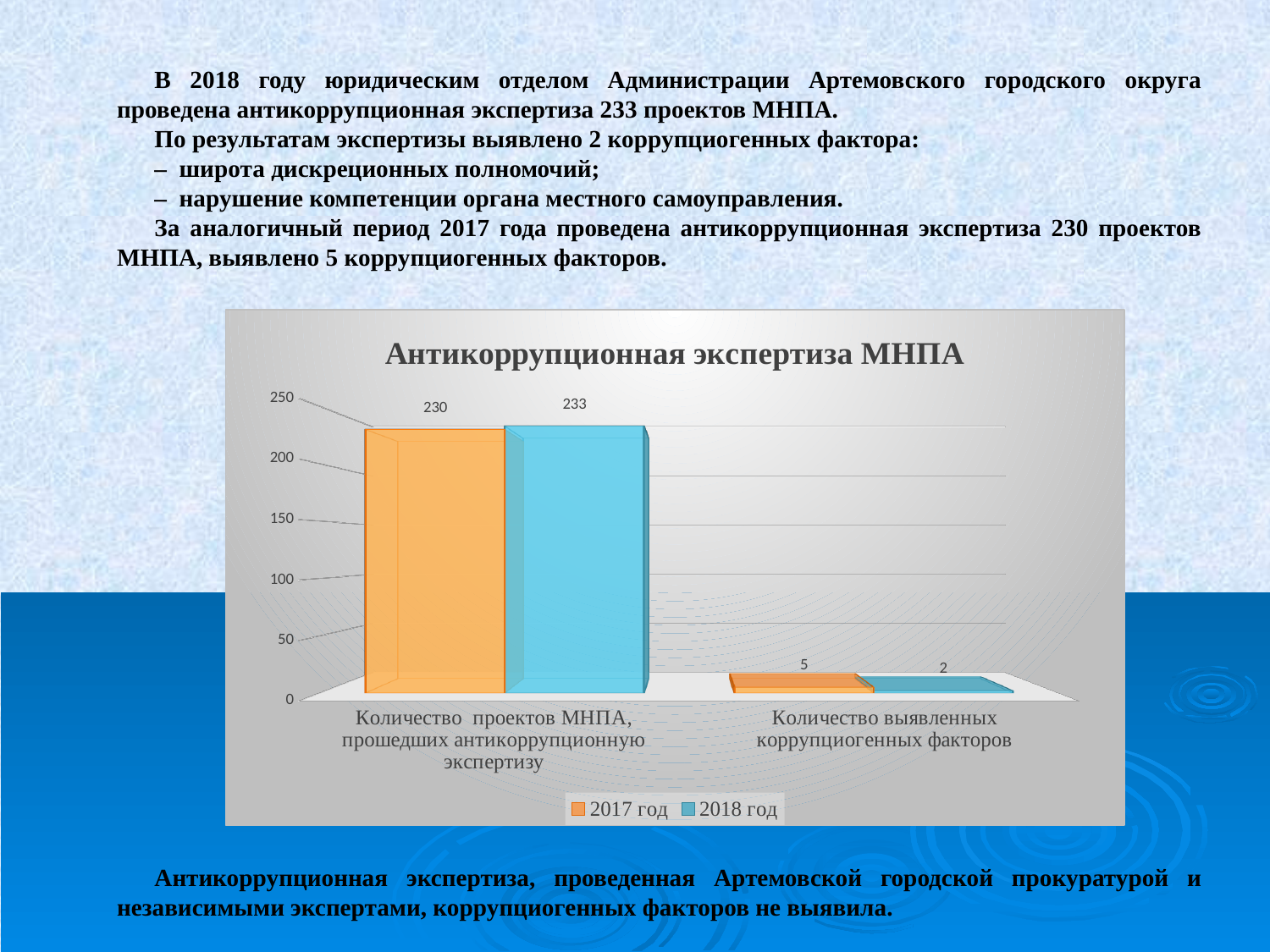
What is the value for 2017 год in the category 'Количество проектов МНПА, прошедших антикоррупционную экспертизу'? 230 Is the 2018 год value for 'Количество проектов МНПА, прошедших антикоррупционную экспертизу' greater or less than 200? greater How many categories are shown on the x axis of the chart? 2 What is the difference between the 2018 год and 2017 год values for 'Количество проектов МНПА, прошедших антикоррупционную экспертизу'? 3 What is the value for 2018 год in the category 'Количество проектов МНПА, прошедших антикоррупционную экспертизу'? 233 What is the title of the chart? Антикоррупционная экспертиза МНПА What is the difference between the 2017 год and 2018 год values for 'Количество выявленных коррупциогенных факторов'? 3 What is the value for 2018 год in the category 'Количество выявленных коррупциогенных факторов'? 2 What is the value for 2017 год in the category 'Количество выявленных коррупциогенных факторов'? 5 What kind of chart is shown on the slide? bar chart How many series does the legend list? 2 Which series has the larger value for 'Количество выявленных коррупциогенных факторов', 2017 год or 2018 год? 2017 год